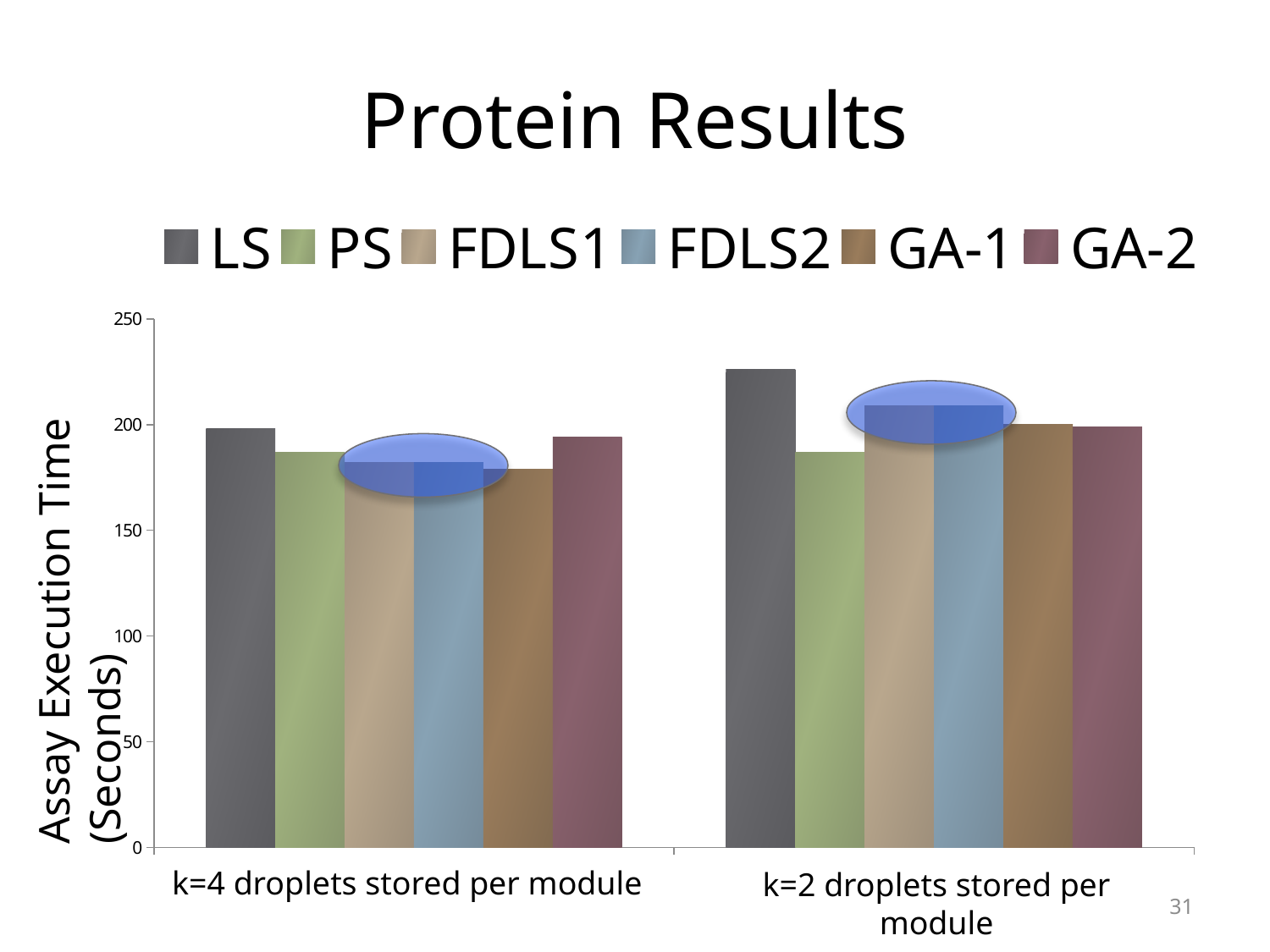
How many categories are shown on the x axis? 2 What is the label on the y axis? Assay Execution Time (Seconds) Is the value for GA-1 at k=4 droplets stored per module greater or less than 200? less Which series has the lowest value for k=2 droplets stored per module? PS How many series does the legend list? 6 Is the value for LS at k=2 droplets stored per module greater or less than 200? greater What kind of chart is shown on the slide? bar chart What is the title of the slide? Protein Results Which series has the highest value for k=2 droplets stored per module? LS Which is larger: the LS value for k=4 droplets stored per module or the LS value for k=2 droplets stored per module? k=2 droplets stored per module Which is larger for k=4 droplets stored per module: LS or PS? LS Is the value for PS at k=4 droplets stored per module greater or less than 200? less